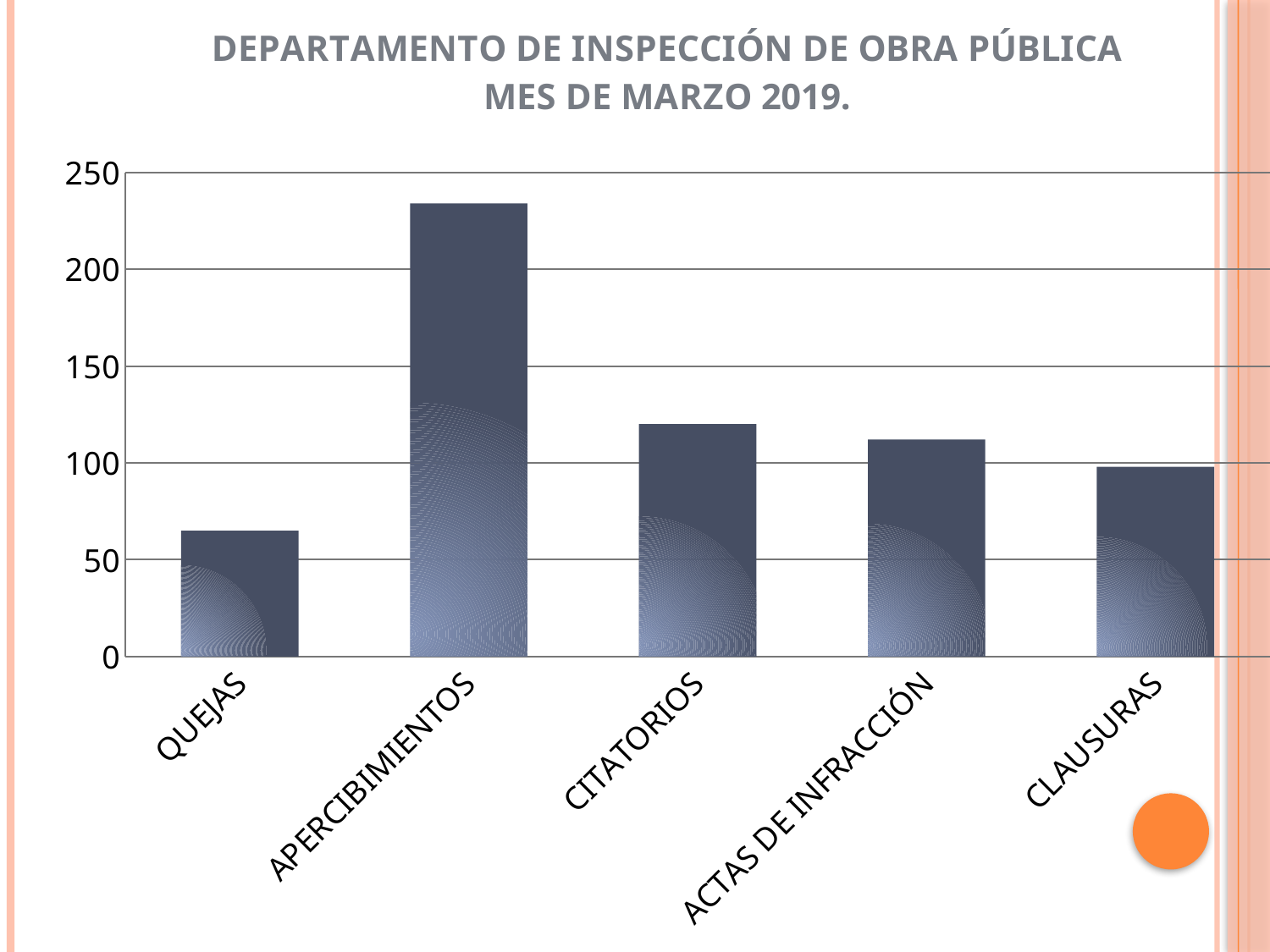
What kind of chart is shown on the slide? bar chart Which is larger, the value for QUEJAS or the value for CITATORIOS? CITATORIOS How many categories are shown on the x axis of the chart? 5 Which category has the highest value in the chart? APERCIBIMIENTOS Which category has the lowest value in the chart? QUEJAS Is the value for APERCIBIMIENTOS greater or less than 200? greater Which is larger, the value for CLAUSURAS or the value for ACTAS DE INFRACCIÓN? ACTAS DE INFRACCIÓN Is the value for CITATORIOS greater or less than 100? greater Is the value for QUEJAS greater or less than 100? less What month and year does the chart title say the data is for? MARZO 2019